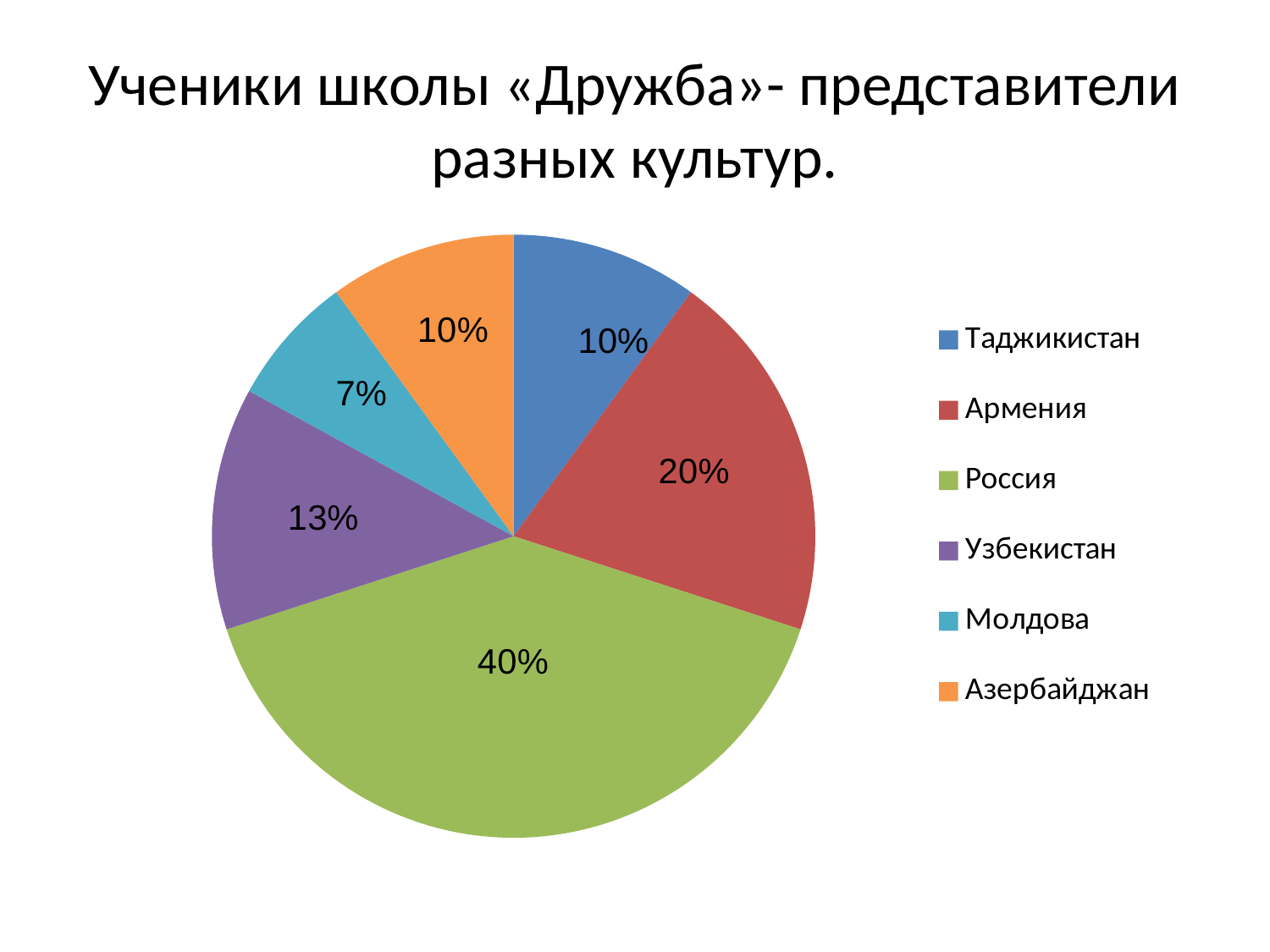
How many categories does the pie chart show? 6 What share of the pie does Таджикистан represent? 10% What share of the pie does Узбекистан represent? 13% Which has a larger share, Узбекистан or Молдова? Узбекистан What colour is the slice for Азербайджан? orange What share of the pie does Молдова represent? 7% Which category has the largest slice of the pie? Россия What kind of chart is shown on the slide? pie chart What is the difference in percentage points between the shares of Россия and Армения? 20% Which category has the smallest slice of the pie? Молдова